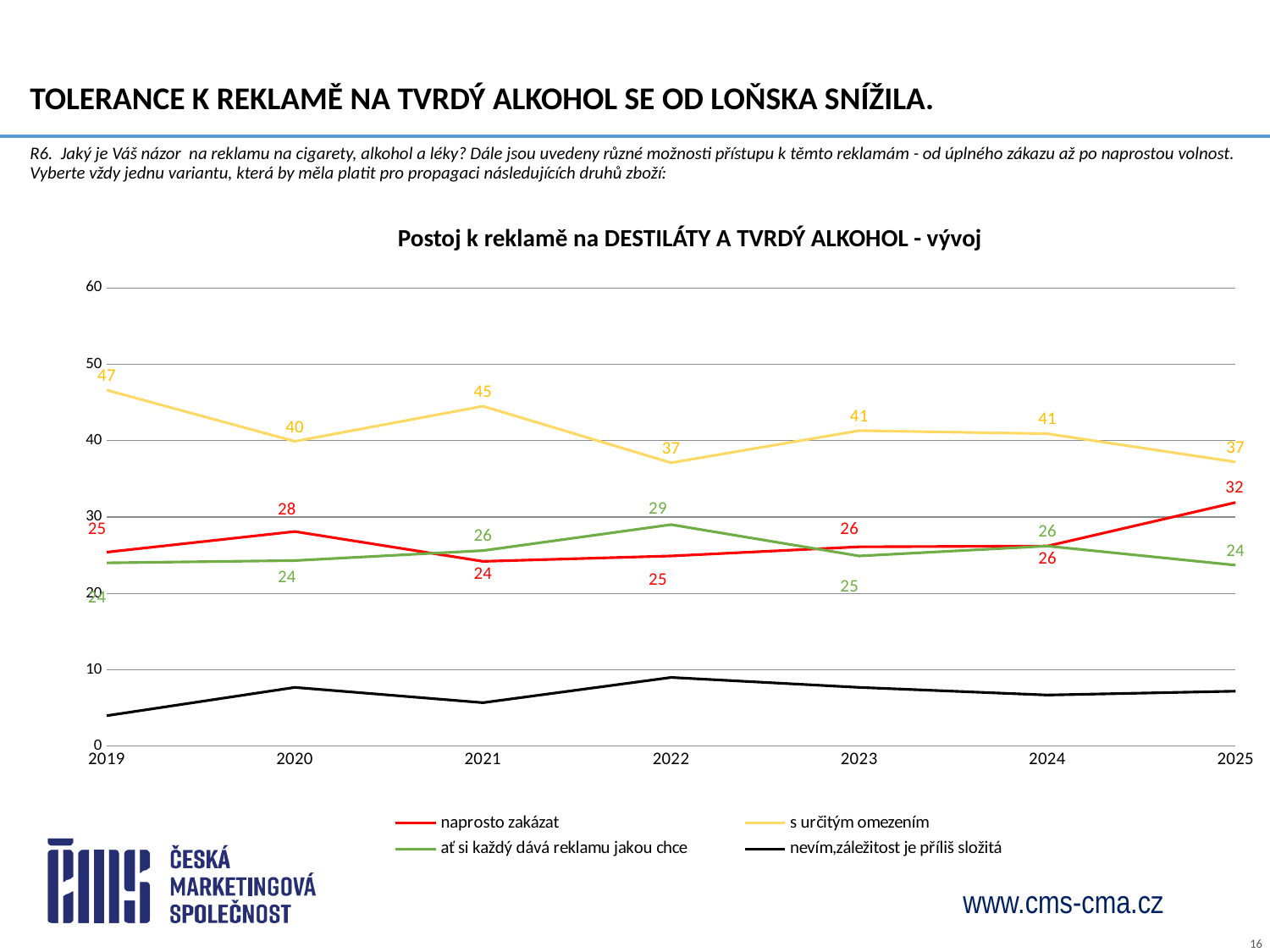
What is the value for 's určitým omezením' in 2019? 47 In which year is the value for 's určitým omezením' highest? 2019 What is the value for 'ať si každý dává reklamu jakou chce' in 2022? 29 Does the value for 'naprosto zakázat' rise or fall from 2024 to 2025? rise How many years are shown on the x axis? 7 What is the difference between the 's určitým omezením' values in 2019 and 2025? 10 How many series does the legend list? 4 Is the value for 'nevím,záležitost je příliš složitá' in 2022 greater or less than 10? less Which is larger in 2022: 'naprosto zakázat' or 'ať si každý dává reklamu jakou chce'? ať si každý dává reklamu jakou chce What type of chart is shown on the slide? line chart What is the value for 'naprosto zakázat' in 2025? 32 In which year is the value for 'naprosto zakázat' lowest? 2021